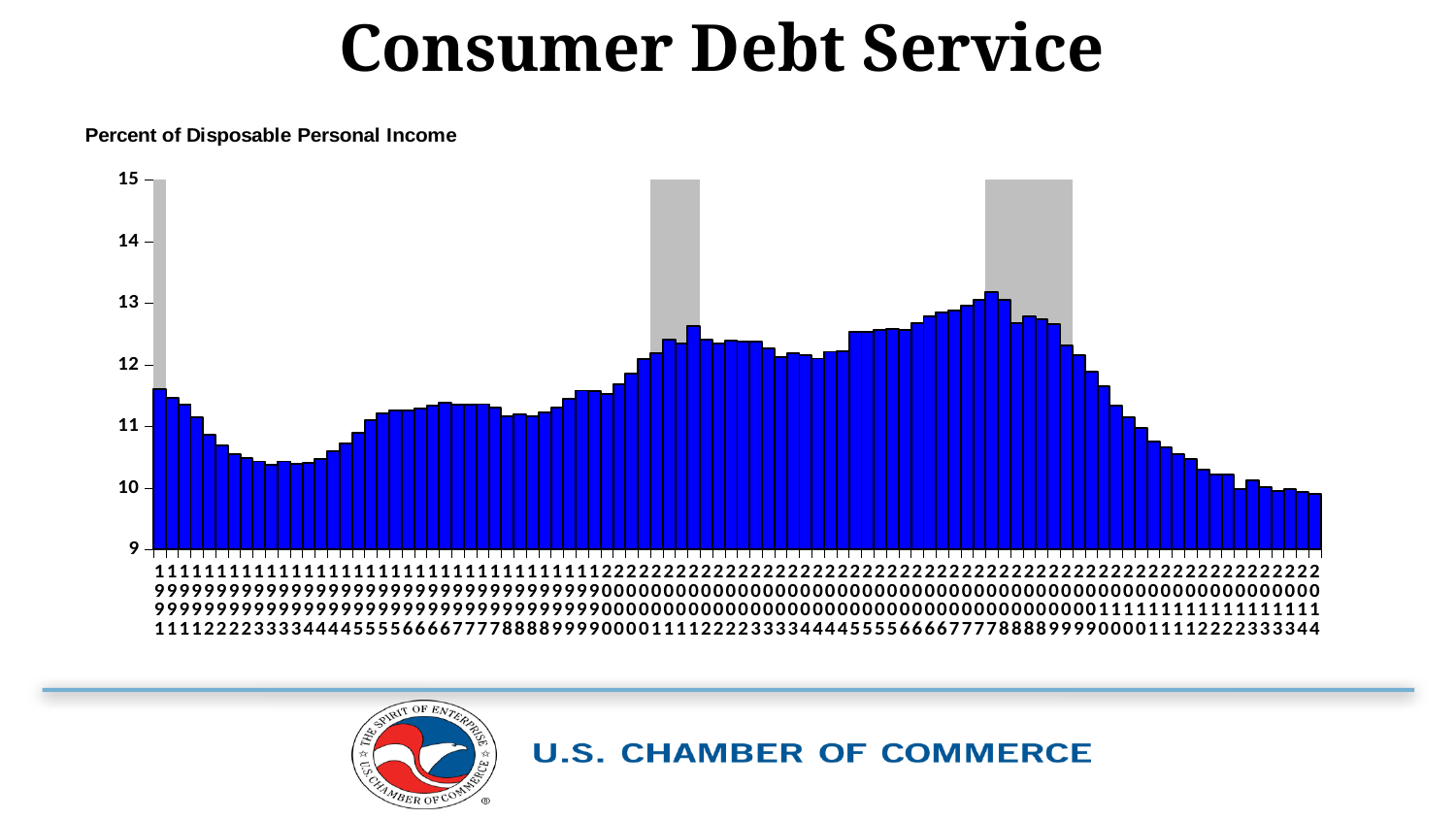
How many gray shaded regions are there on the chart? 3 What is the label on the vertical axis of the chart? Percent of Disposable Personal Income What kind of chart is shown on the slide? bar chart Which is larger, the value in 1991 or the value in 2014? 1991 Do the values rise or fall from 2008 to 2014? fall Is the value for the first bar (1991) greater or less than 11? greater Do the values rise or fall from 2001 to 2007? rise Is the value for the highest bar in 2007 greater or less than 12? greater Which is larger, the value in 1995 or the value in 2007? 2007 Is the value for the last bar (2014) greater or less than 11? less What is the title of the chart? Consumer Debt Service